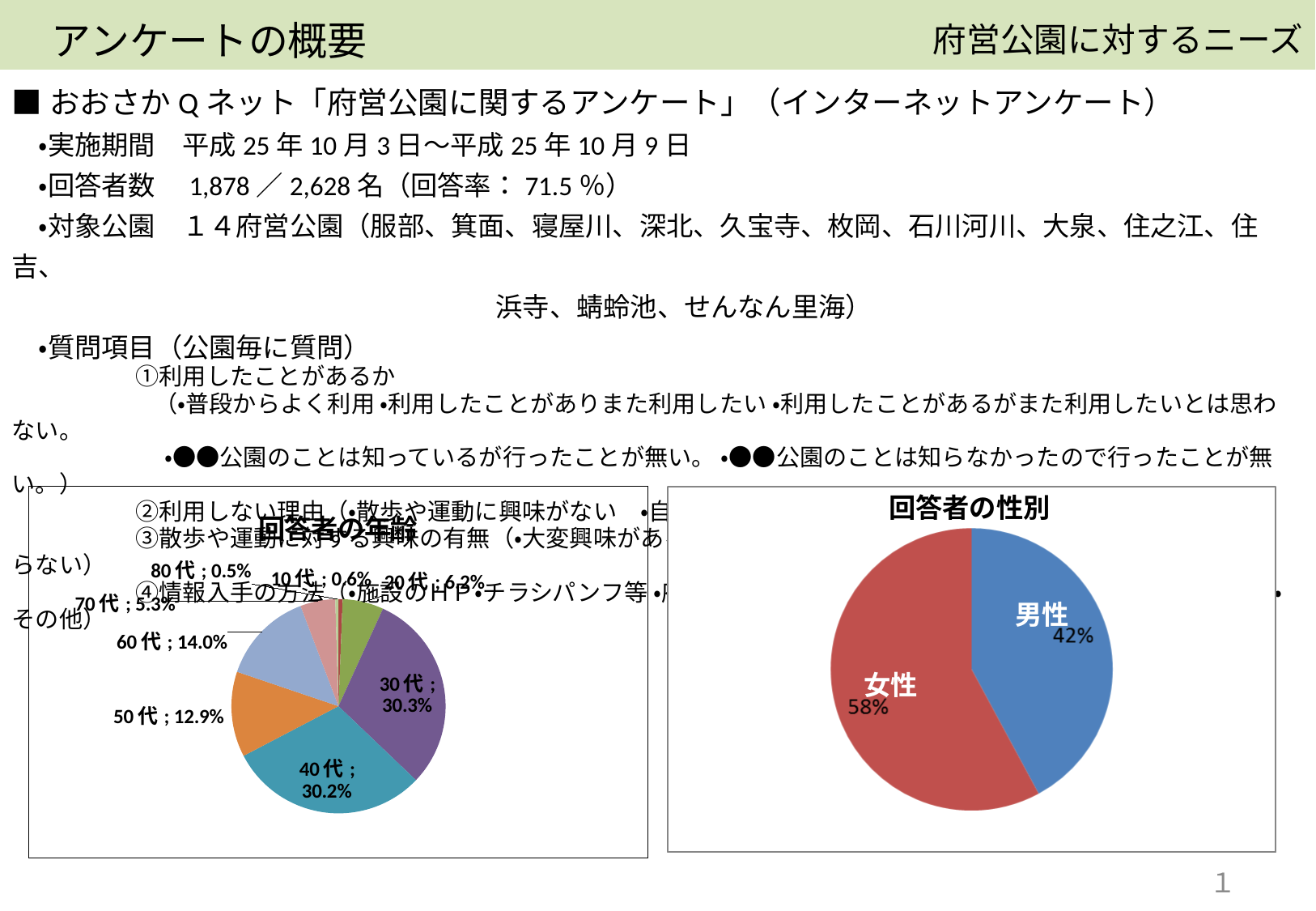
In the 回答者の性別 chart, what share of respondents are 男性? 42% In the 回答者の性別 chart, what is the difference between the 女性 and 男性 shares? 16 percentage points In the 回答者の年齢 chart, what is the value for 30代? 30.3% In the 回答者の年齢 chart, what is the value for 50代? 12.9% In the 回答者の性別 chart, what share of respondents are 女性? 58% In the 回答者の年齢 chart, what is the value for 40代? 30.2% In the 回答者の年齢 chart, what is the value for 60代? 14.0% In the 回答者の性別 chart, which slice is larger, 男性 or 女性? 女性 How many slices does the 回答者の性別 pie chart have? 2 What kind of chart is the 回答者の性別 chart? pie chart In the 回答者の年齢 chart, what is the difference between the 60代 and 50代 values? 1.1 percentage points How many age groups are shown in the 回答者の年齢 pie chart? 8